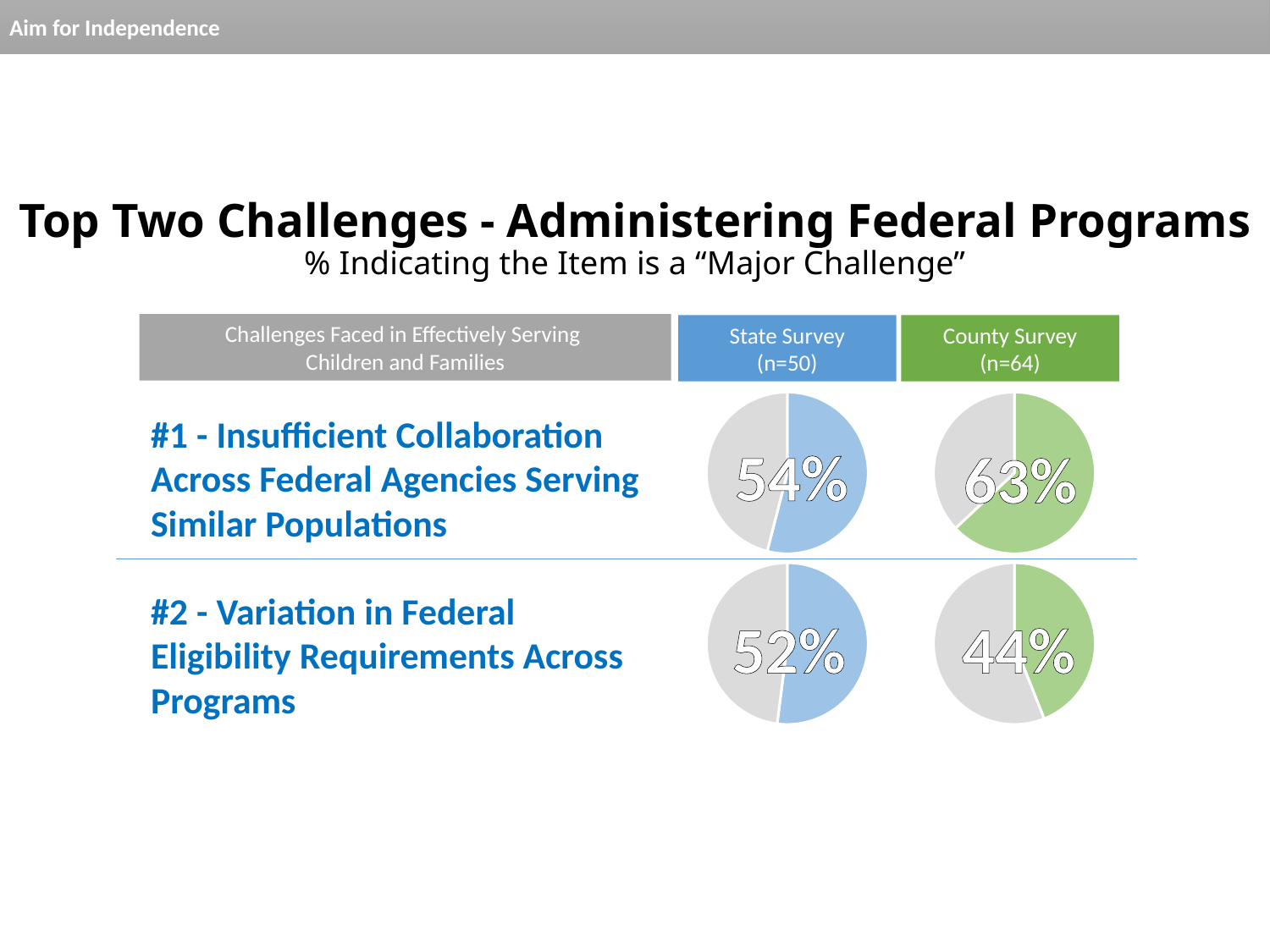
What is the difference between the County Survey and State Survey percentages for challenge #1? 9 percentage points Across all four pie charts on the slide, which one shows the lowest percentage? County Survey, challenge #2 (44%) For challenge #1, which survey shows the higher percentage calling it a major challenge, the State Survey or the County Survey? County Survey In the County Survey pie chart for challenge #2 (Variation in Federal Eligibility Requirements Across Programs), what percentage indicated it is a major challenge? 44% For challenge #2, which survey shows the higher percentage calling it a major challenge, the State Survey or the County Survey? State Survey What type of chart is used to display the survey percentages on this slide? Pie chart In the State Survey pie chart for challenge #2 (Variation in Federal Eligibility Requirements Across Programs), what percentage indicated it is a major challenge? 52% In the County Survey pie chart for challenge #1 (Insufficient Collaboration Across Federal Agencies Serving Similar Populations), what percentage indicated it is a major challenge? 63% What is the difference between the State Survey and County Survey percentages for challenge #2? 8 percentage points In the State Survey pie chart for challenge #1 (Insufficient Collaboration Across Federal Agencies Serving Similar Populations), what percentage indicated it is a major challenge? 54% How many pie charts are shown on the slide? 4 Across all four pie charts on the slide, which one shows the highest percentage? County Survey, challenge #1 (63%)